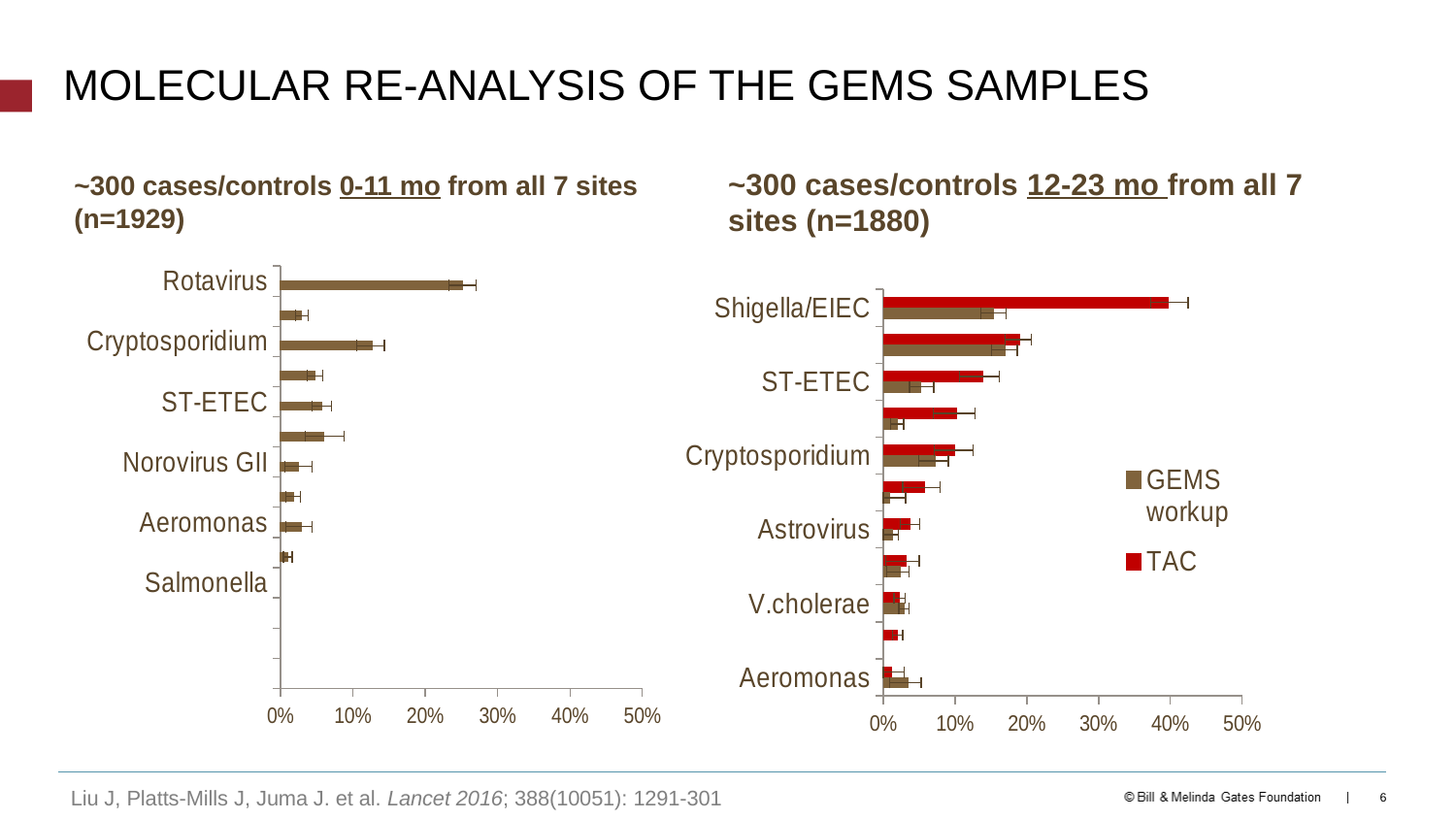
In the chart titled "~300 cases/controls 12-23 mo from all 7 sites (n=1880)", which is larger for Shigella/EIEC, the TAC value or the GEMS workup value? TAC In the chart titled "~300 cases/controls 0-11 mo from all 7 sites (n=1929)", is the value for ST-ETEC greater or less than 10%? less What kind of chart is the chart titled "~300 cases/controls 0-11 mo from all 7 sites (n=1929)"? Bar chart In the chart titled "~300 cases/controls 0-11 mo from all 7 sites (n=1929)", which labelled pathogen has the highest value? Rotavirus In the chart titled "~300 cases/controls 12-23 mo from all 7 sites (n=1880)", which labelled pathogen has the highest TAC value? Shigella/EIEC How many series does the legend list for the chart titled "~300 cases/controls 12-23 mo from all 7 sites (n=1880)"? 2 In the chart titled "~300 cases/controls 12-23 mo from all 7 sites (n=1880)", which series is shown in red? TAC In the chart titled "~300 cases/controls 0-11 mo from all 7 sites (n=1929)", is the value for Rotavirus greater or less than 20%? greater In the chart titled "~300 cases/controls 0-11 mo from all 7 sites (n=1929)", which is larger, the value for Rotavirus or the value for Cryptosporidium? Rotavirus What kind of chart is the chart titled "~300 cases/controls 12-23 mo from all 7 sites (n=1880)"? Bar chart In the chart titled "~300 cases/controls 0-11 mo from all 7 sites (n=1929)", is the value for Cryptosporidium greater or less than 10%? greater